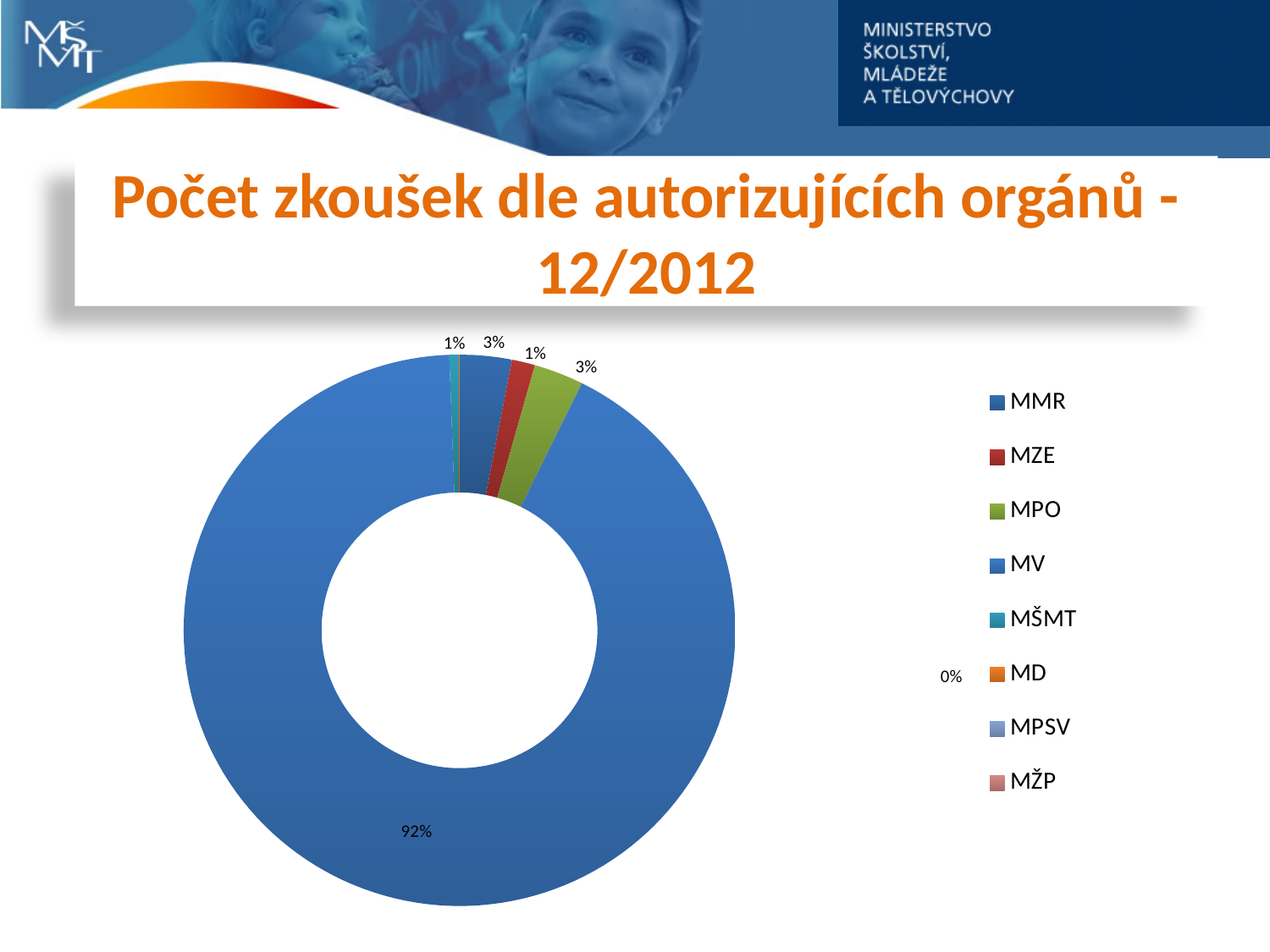
Which authorizing body has the largest share of exams? MV What is the title of the chart on the slide? Počet zkoušek dle autorizujících orgánů - 12/2012 Which has a larger share, MPO or MZE? MPO What share of exams does MZE account for? 1% How many entries does the chart legend list? 8 What colour represents MZE in the legend? red What is the difference in percentage points between the MMR share and the MPO share? 0% What kind of chart is shown on the slide? doughnut (pie) chart Is the share for MMR greater or less than 50%? less What share of exams does MPO account for? 3% Which legend entry is listed last? MŽP What share of exams does MMR account for? 3%